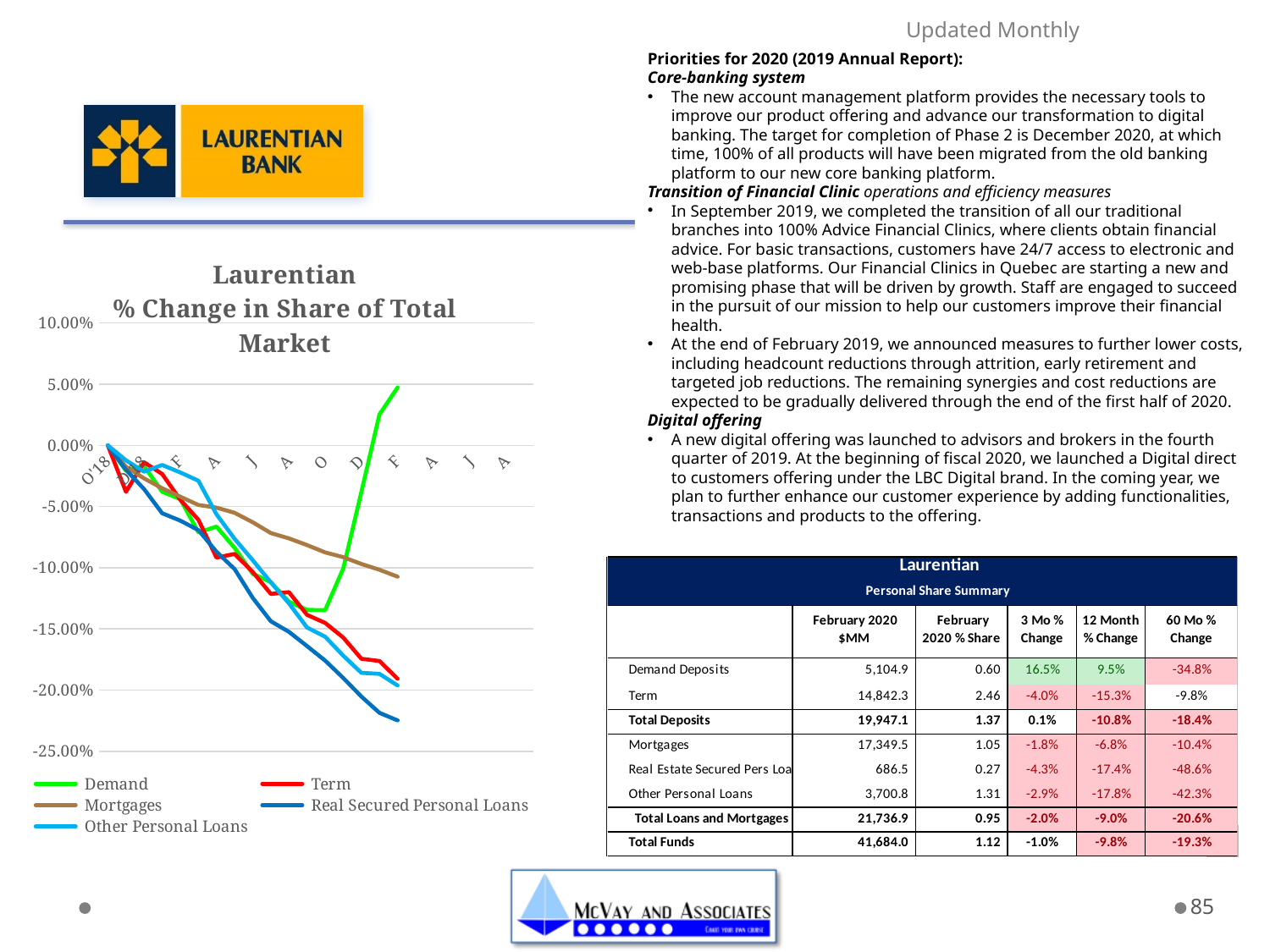
What kind of chart is shown on the slide? line chart What is the title of the chart? Laurentian % Change in Share of Total Market Which colour is used for the Demand series in the chart? green Do the values for Mortgages rise or fall along the x axis? fall Which series has the highest value at the right end of the chart? Demand Is the final value for Term greater or less than -15.00%? less Is the final value for Demand greater or less than 0.00%? greater Is the final value for Mortgages greater or less than -15.00%? greater At the right end of the chart, which is larger: the value for Mortgages or the value for Real Secured Personal Loans? Mortgages Which series has the lowest value at the right end of the chart? Real Secured Personal Loans How many series does the chart legend list? 5